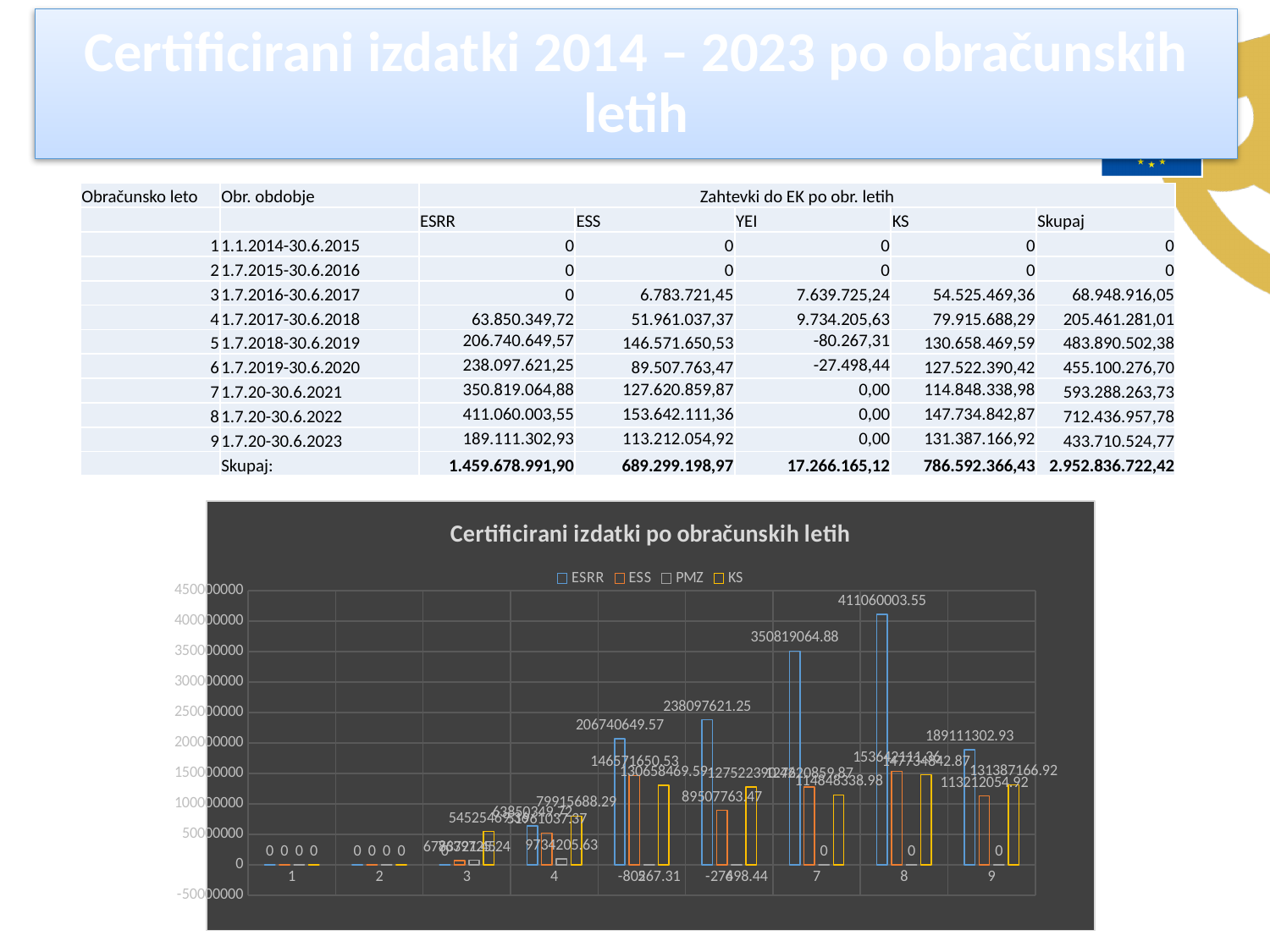
What is the title of the chart? Certificirani izdatki po obračunskih letih What is the difference between the ESRR values for category 8 and category 7? 60240938.67 Which is larger in the chart: the ESRR value for category 7 or for category 6? category 7 Is the ESRR value for category 8 greater or less than 400000000? greater What kind of chart is shown on the slide? bar chart How many categories are shown along the x axis of the chart? 9 What is the ESRR value for category 6 in the chart? 238097621.25 What is the ESRR value for category 7 in the chart? 350819064.88 What is the ESRR value for category 8 in the chart? 411060003.55 Which category has the highest ESRR value in the chart? 8 How many series does the chart legend list? 4 What is the ESRR value for category 9 in the chart? 189111302.93